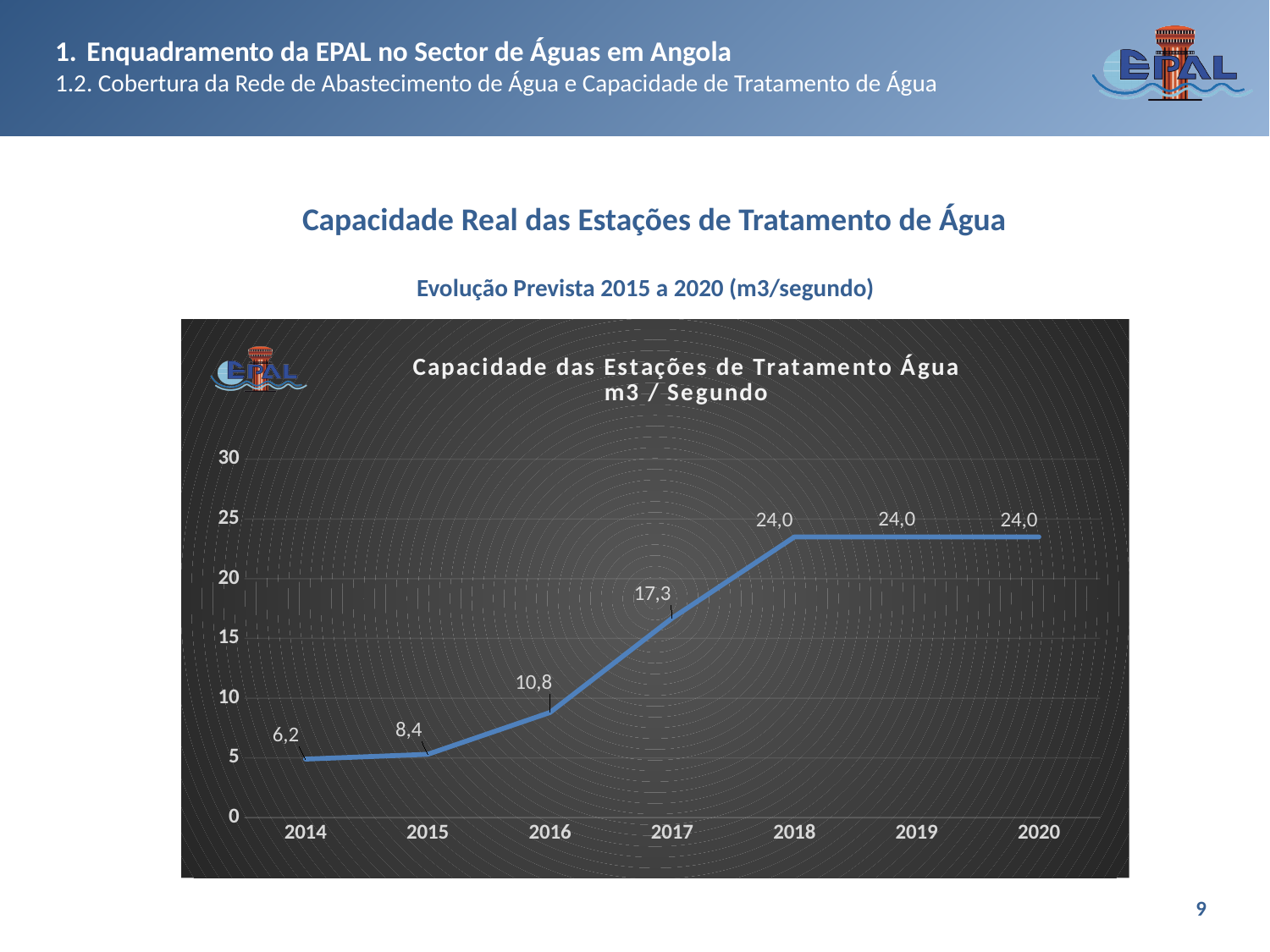
What is the title of the chart? Capacidade das Estações de Tratamento Água m3 / Segundo What is the difference between the values for 2018 and 2014? 17,8 What is the value for 2016? 10,8 Which year has the lowest value? 2014 What is the value for 2017? 17,3 What type of chart is shown on the slide? line chart What is the value for 2014? 6,2 Do the values rise or fall from 2014 to 2018? rise What is the difference between the values for 2017 and 2016? 6,5 How many years are plotted on the x axis? 7 What is the value for 2019? 24,0 Which is larger, the value for 2015 or the value for 2017? 2017